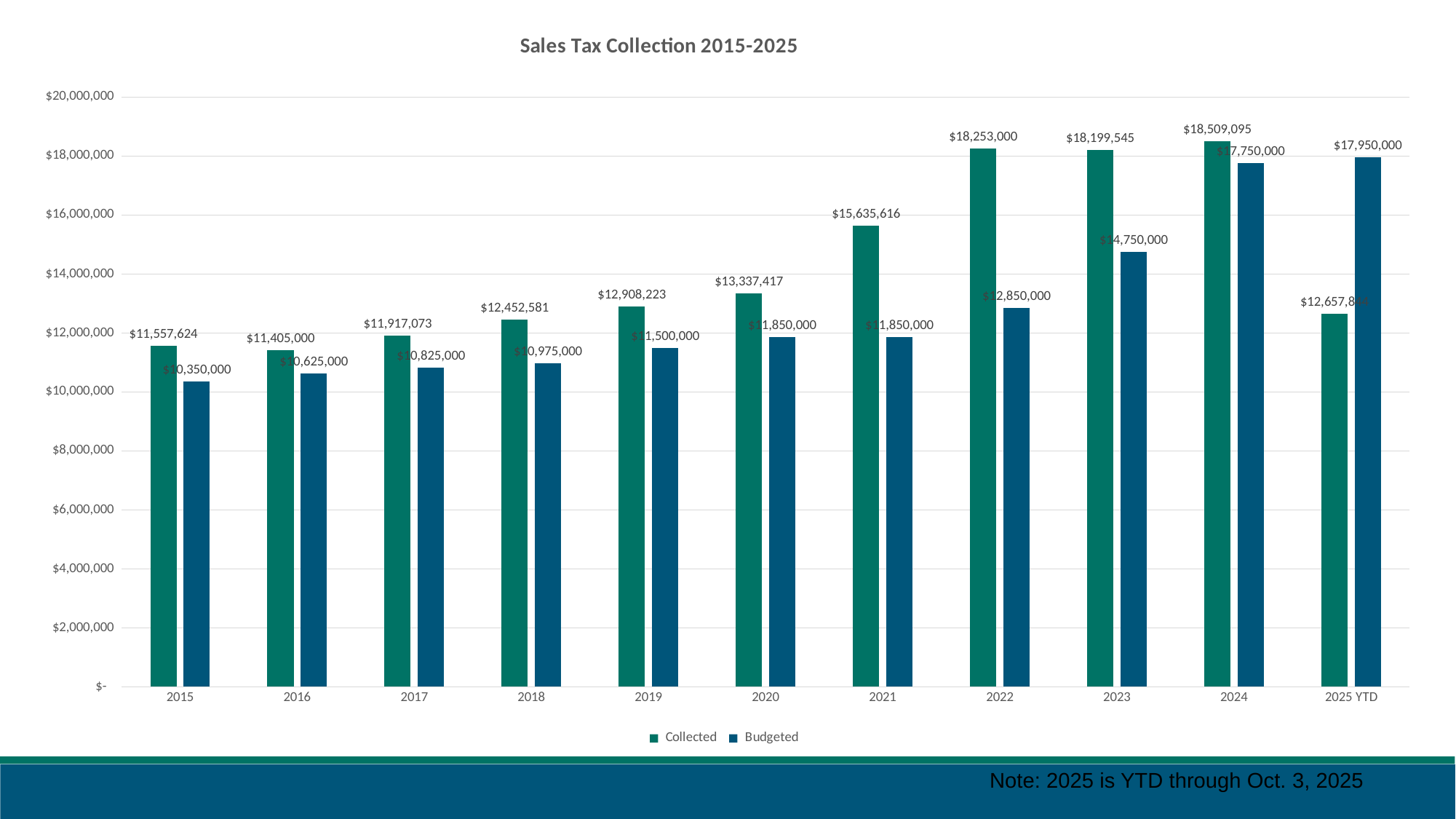
Do the Budgeted values generally rise or fall from 2015 to 2025 YTD? Rise Which is larger for 2021, the Collected value or the Budgeted value? Collected What type of chart is shown on the slide? Bar chart Is the Collected value for 2021 greater or less than $14,000,000? greater Which year has the lowest Budgeted value? 2015 How many year categories are shown on the x axis? 11 What is the title of the chart? Sales Tax Collection 2015-2025 What was the Budgeted value for 2023? $14,750,000 What was the Collected value for 2019? $12,908,223 What is the difference between the Collected and Budgeted values for 2024? $759,095 Which year has the highest Collected value? 2024 How many series does the legend list? 2